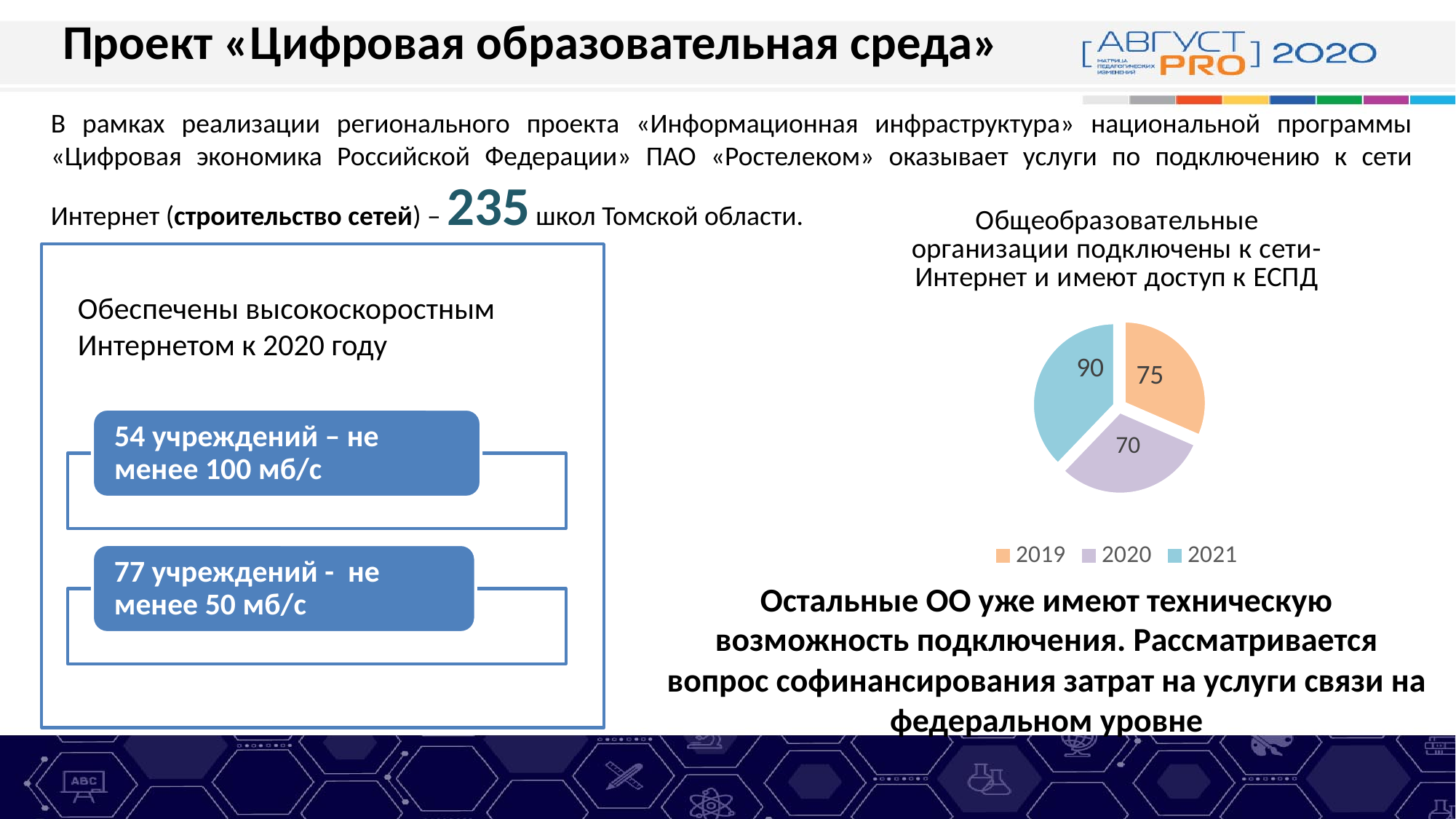
Which years are listed in the legend of the pie chart? 2019, 2020, 2021 What is the value for 2020 in the pie chart? 70 Which is larger in the pie chart, the value for 2019 or the value for 2021? 2021 What is the value for 2021 in the pie chart? 90 What is the difference between the values for 2019 and 2020 in the pie chart? 5 How many slices does the pie chart have? 3 What is the total of all slices in the pie chart? 235 What type of chart is shown on the slide? pie chart Which year has the smallest slice in the pie chart? 2020 What is the value for 2019 in the pie chart? 75 Which year has the largest slice in the pie chart? 2021 What is the difference between the values for 2021 and 2020 in the pie chart? 20